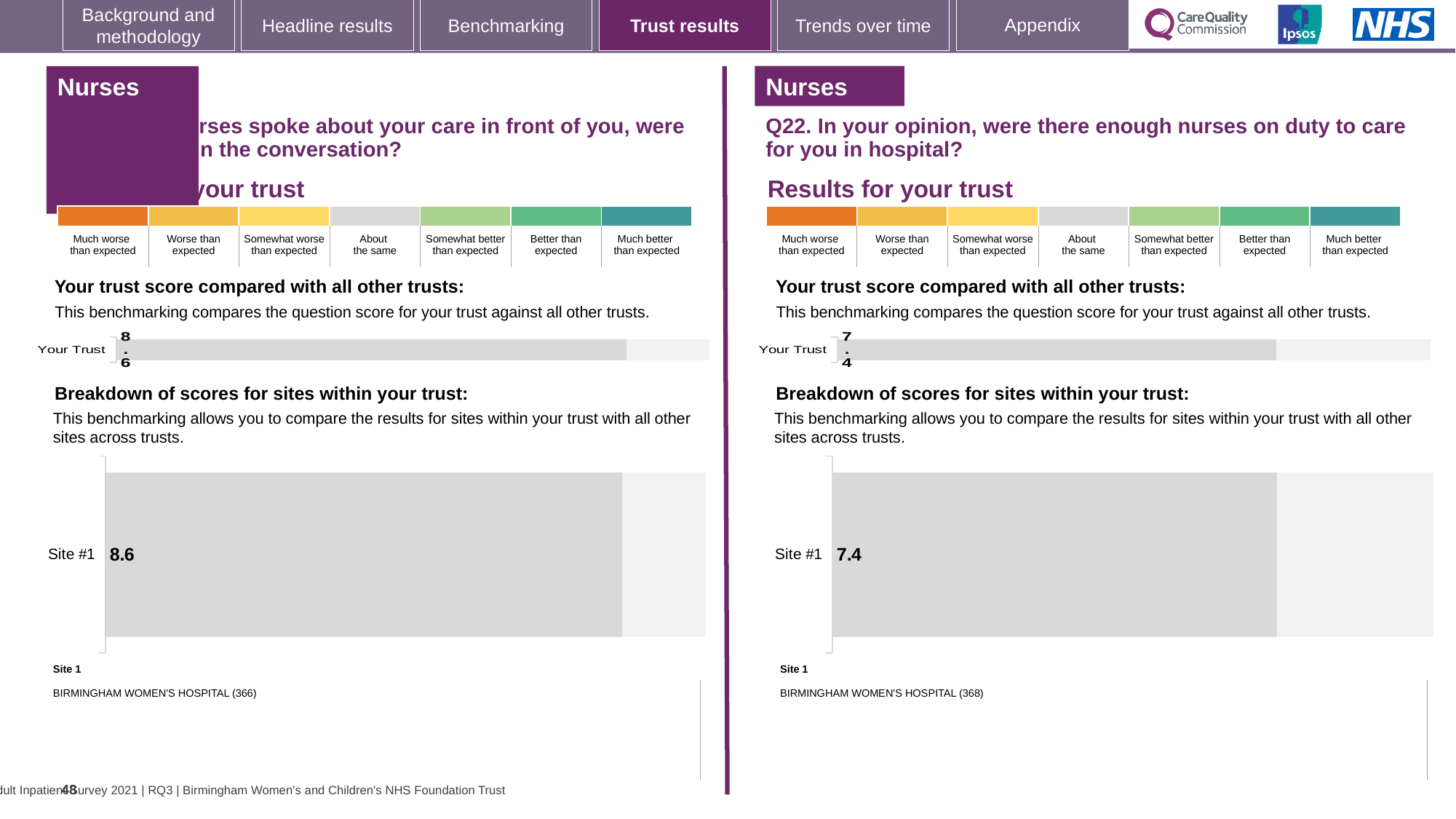
In the left-hand 'Your trust score compared with all other trusts' chart, what is the value shown for Your Trust? 8.6 What is the difference between the Site #1 value in the left-hand site breakdown chart and the Site #1 value in the right-hand site breakdown chart? 1.2 Comparing the Your Trust values in the left-hand and right-hand 'Your trust score compared with all other trusts' charts, which is larger? Left-hand (8.6) In the right-hand 'Breakdown of scores for sites within your trust' chart (Q22), what is the value labelled for Site #1? 7.4 In the right-hand 'Your trust score compared with all other trusts' chart (Q22), what is the value shown for Your Trust? 7.4 In the left-hand 'Breakdown of scores for sites within your trust' chart, what is the value labelled for Site #1? 8.6 Comparing the Site #1 bars in the left-hand and right-hand site breakdown charts, which side shows the larger value? Left-hand (8.6) How many sites are plotted in the left-hand 'Breakdown of scores for sites within your trust' chart? 1 Which question number do the right-hand charts relate to? Q22 What type of chart is used for the 'Your Trust' score in the right-hand 'Your trust score compared with all other trusts' section? Bar chart Which site is listed as Site 1 beneath the right-hand site breakdown chart? BIRMINGHAM WOMEN'S HOSPITAL (368) How many sites are plotted in the right-hand 'Breakdown of scores for sites within your trust' chart? 1